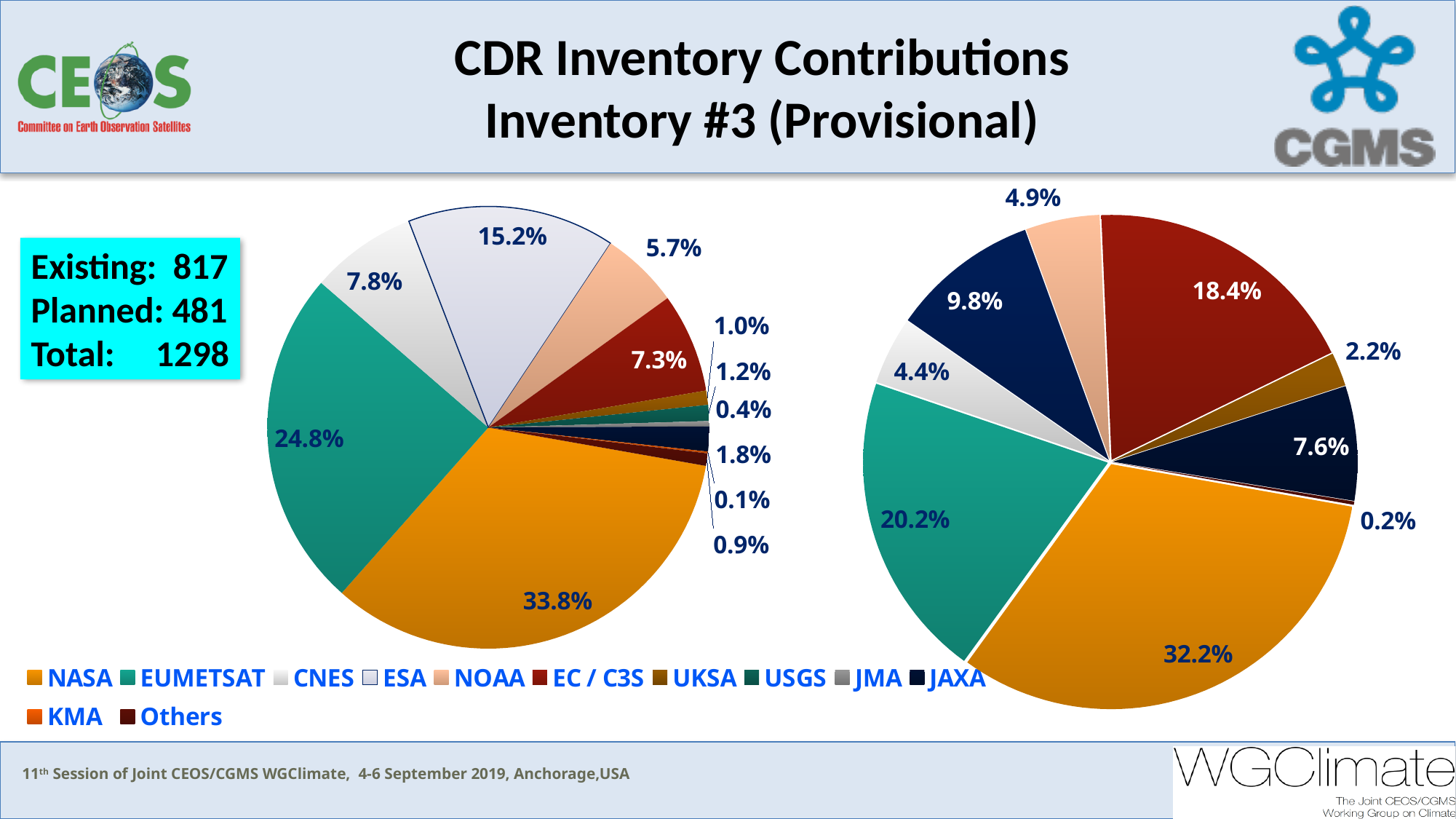
In the left pie chart, what share does ESA have? 15.2% In the right pie chart, what share does EC / C3S have? 18.4% What kind of charts are shown on the slide? Pie charts In the left pie chart, what is the difference between the NASA and EUMETSAT shares? 9.0 percentage points How many entries does the legend list? 12 In the right pie chart, which is larger, the EUMETSAT slice or the EC / C3S slice? EUMETSAT In the right pie chart, what share does NOAA have? 4.9% In the left pie chart, which organisation has the largest slice? NASA